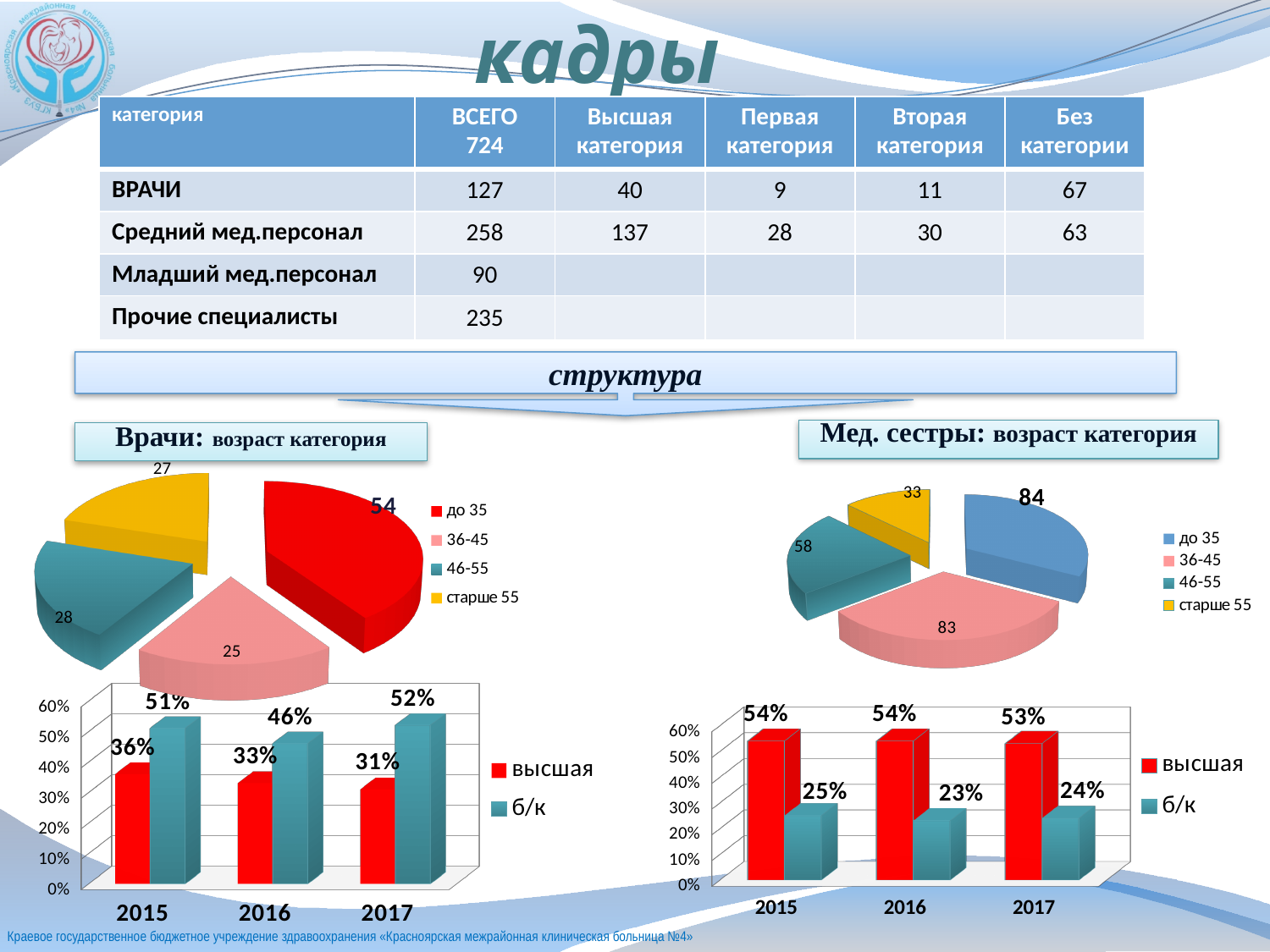
In the pie chart titled 'Мед. сестры: возраст категория', what is the difference between the 'до 35' slice and the 'старше 55' slice? 51 In the bottom-right bar chart (below the 'Мед. сестры' pie chart), what is the value of 'б/к' for 2016? 23% In the pie chart titled 'Врачи: возраст категория', which age category has the smallest value? 36-45 In the bottom-left bar chart (below the 'Врачи' pie chart), does the 'высшая' series rise or fall from 2015 to 2017? fall In the pie chart titled 'Мед. сестры: возраст категория', what is the value for the '46-55' slice? 58 In the bottom-left bar chart (below the 'Врачи' pie chart), what is the difference between 'б/к' and 'высшая' in 2015? 15% In the bottom-left bar chart (below the 'Врачи' pie chart), what is the value of 'высшая' for 2017? 31% What type of chart is shown at the bottom right of the slide, below the 'Мед. сестры' pie chart? bar chart How many series does the legend of the pie chart titled 'Врачи: возраст категория' list? 4 In the pie chart titled 'Мед. сестры: возраст категория', which age category has the largest value? до 35 In the pie chart titled 'Врачи: возраст категория', what is the value for the 'до 35' slice? 54 In the bottom-right bar chart (below the 'Мед. сестры' pie chart), which is larger in 2017: 'высшая' or 'б/к'? высшая